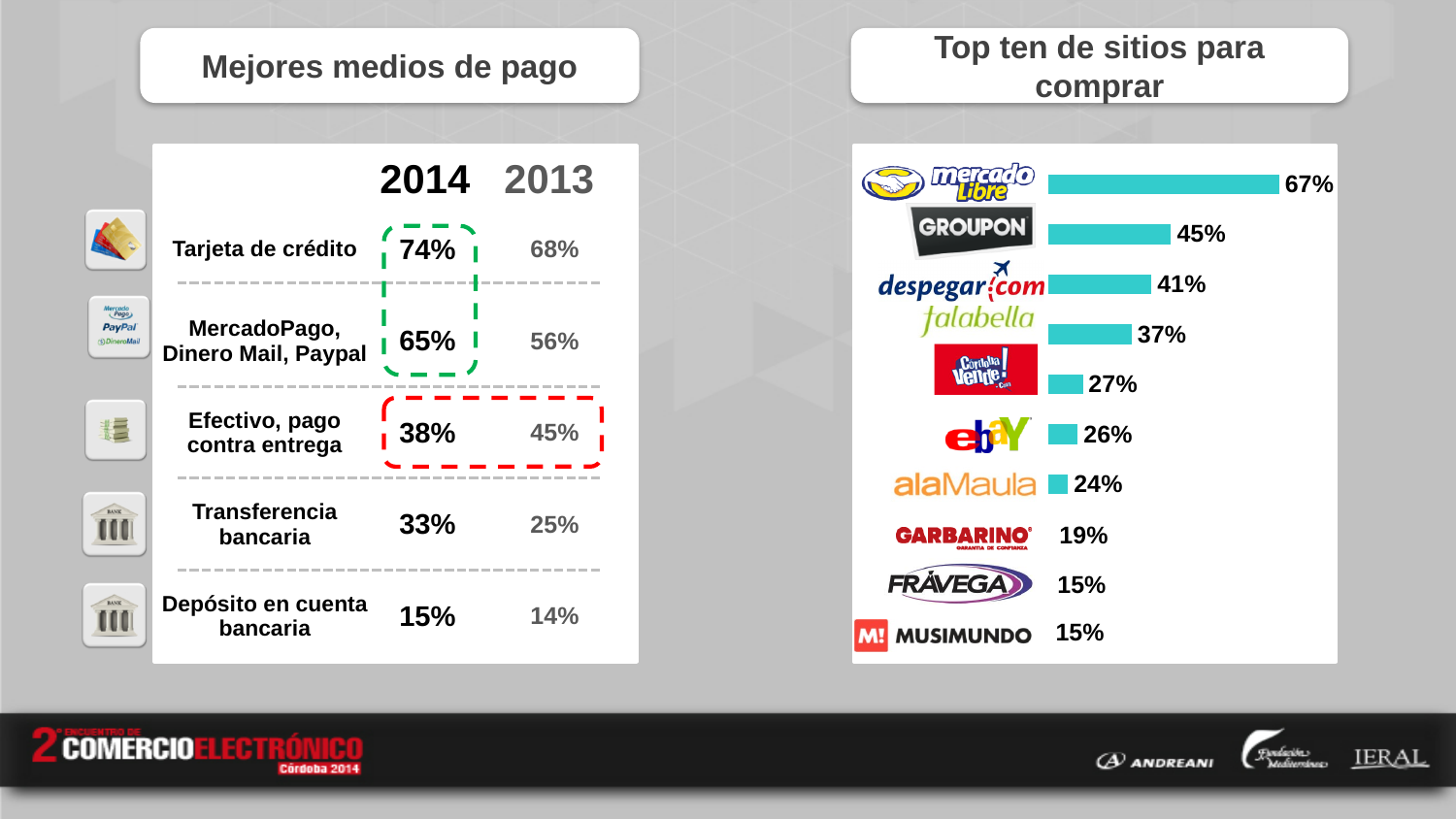
What kind of chart is 'Top ten de sitios para comprar'? Bar chart In the 'Top ten de sitios para comprar' chart, what is the value for Groupon? 45% In the 'Top ten de sitios para comprar' chart, which site has the highest value? Mercado Libre In the 'Top ten de sitios para comprar' chart, what is the difference between Falabella and eBay? 11% In the 'Top ten de sitios para comprar' chart, what is the value for alaMaula? 24% In the 'Top ten de sitios para comprar' chart, what is the value for Mercado Libre? 67% In the 'Top ten de sitios para comprar' chart, what is the value for despegar.com? 41% In the 'Top ten de sitios para comprar' chart, what is the difference between Mercado Libre and Groupon? 22% In the 'Top ten de sitios para comprar' chart, which is larger, Garbarino or Córdoba Vende? Córdoba Vende In the 'Top ten de sitios para comprar' chart, which two sites share the lowest value of 15%? Frávega and Musimundo What is the title of the chart on the right side of the slide? Top ten de sitios para comprar How many sites are listed in the 'Top ten de sitios para comprar' chart? 10